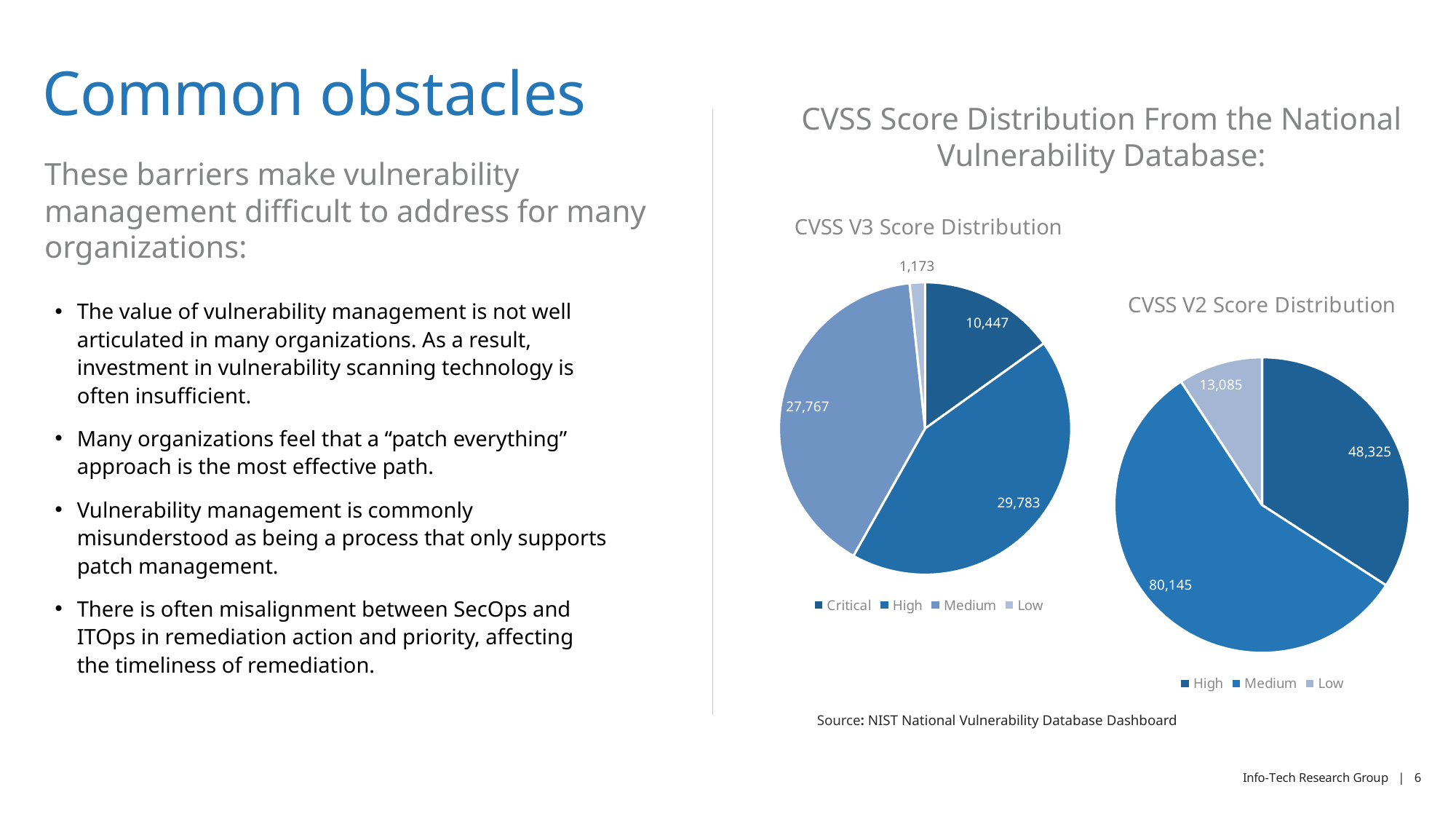
In the CVSS V2 Score Distribution chart, what is the value for Medium? 80,145 In the CVSS V3 Score Distribution chart, which category has the largest value? High In the CVSS V2 Score Distribution chart, what is the value for High? 48,325 How many categories does the legend of the CVSS V2 Score Distribution chart list? 3 What source is cited below the charts? NIST National Vulnerability Database Dashboard In the CVSS V2 Score Distribution chart, what is the difference between the Medium and High values? 31,820 In the CVSS V3 Score Distribution chart, what is the value for Critical? 10,447 In the CVSS V3 Score Distribution chart, what is the value for Low? 1,173 In the CVSS V2 Score Distribution chart, which category has the smallest value? Low In the CVSS V3 Score Distribution chart, what is the difference between the High and Medium values? 2,016 What kind of chart is the CVSS V3 Score Distribution? Pie chart In the CVSS V3 Score Distribution chart, which is larger, Critical or Medium? Medium